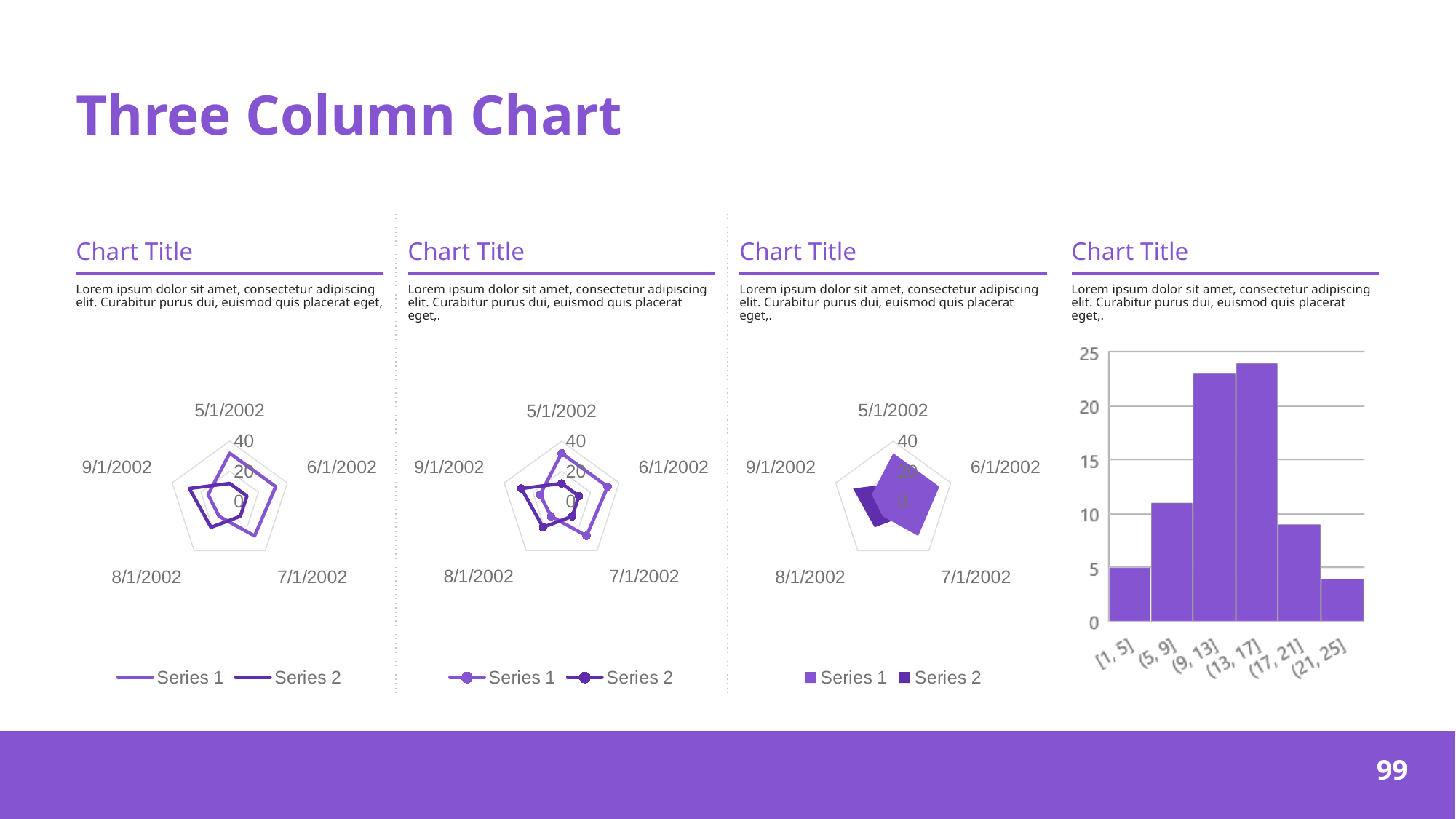
How many categories (axes) does the leftmost radar chart have? 5 In the rightmost chart, is the value for the (17, 21] bin greater or less than 10? less How many series does the legend of the leftmost chart list? 2 What kind of chart is the leftmost chart on the slide? radar chart In the leftmost chart, is the Series 1 value for 6/1/2002 greater or less than 20? greater What are the legend entries of the third chart from the left? Series 1, Series 2 In the rightmost chart, which bin has the larger value, (5, 9] or (9, 13]? (9, 13] In the rightmost chart, is the value for the (9, 13] bin greater or less than 20? greater What kind of chart is the rightmost chart on the slide? bar chart In the rightmost chart, what is the value for the [1, 5] bin? 5 How many bins are shown on the x axis of the rightmost chart? 6